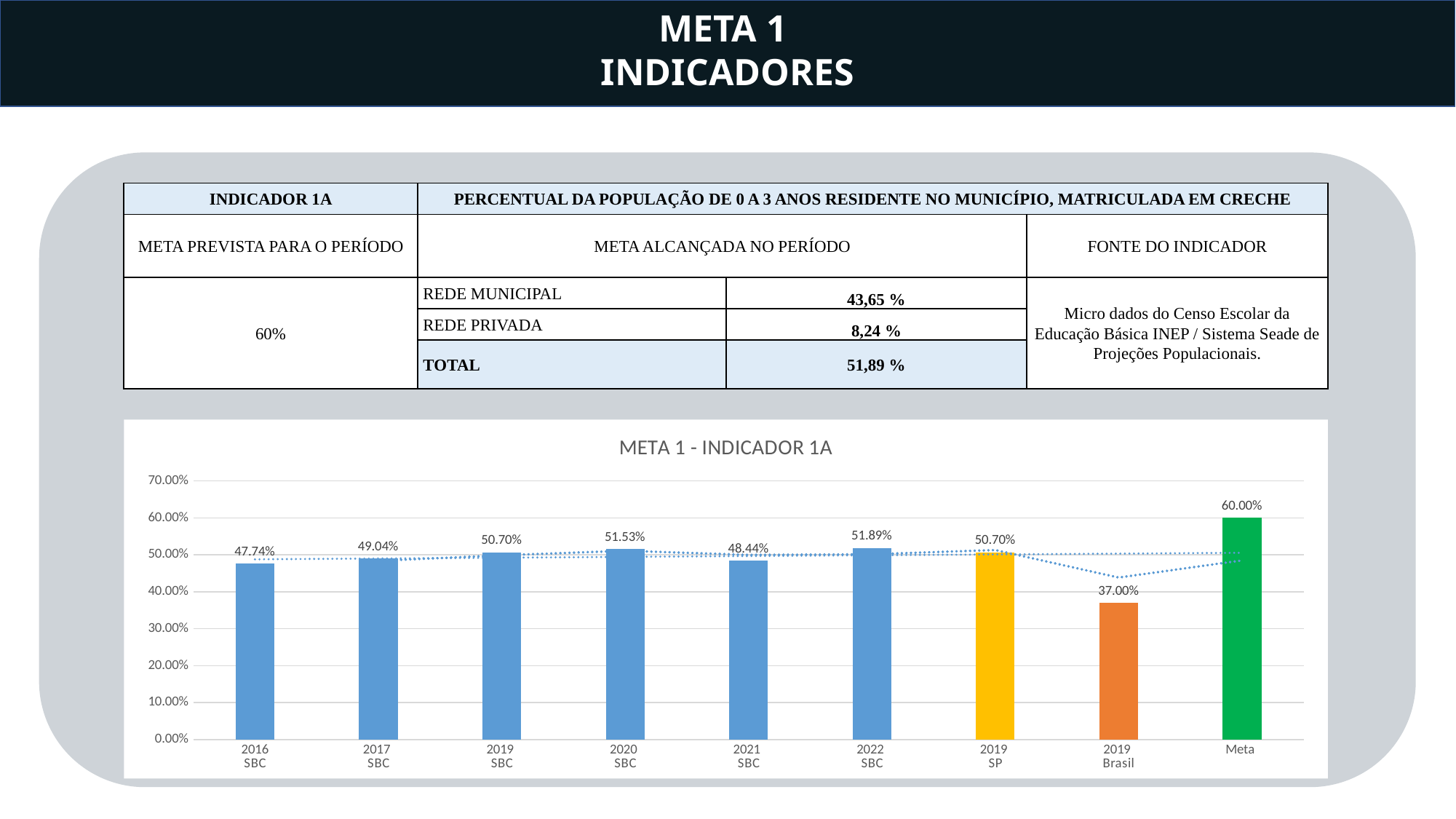
Which is larger, the value for 2020 SBC or the value for 2021 SBC? 2020 SBC Which category has the highest bar in the chart? Meta What kind of chart is shown on the slide? bar chart What is the value for 2022 SBC in the chart? 51.89% What is the value for 2016 SBC in the chart? 47.74% What is the title of the chart? META 1 - INDICADOR 1A What is the value of the Meta bar in the chart? 60.00% What is the value for 2019 Brasil in the chart? 37.00% Which category has the lowest bar in the chart? 2019 Brasil How many bars are shown in the chart? 9 What is the difference between the Meta value and the 2022 SBC value? 8.11% Is the value for 2019 Brasil greater or less than 40.00%? less